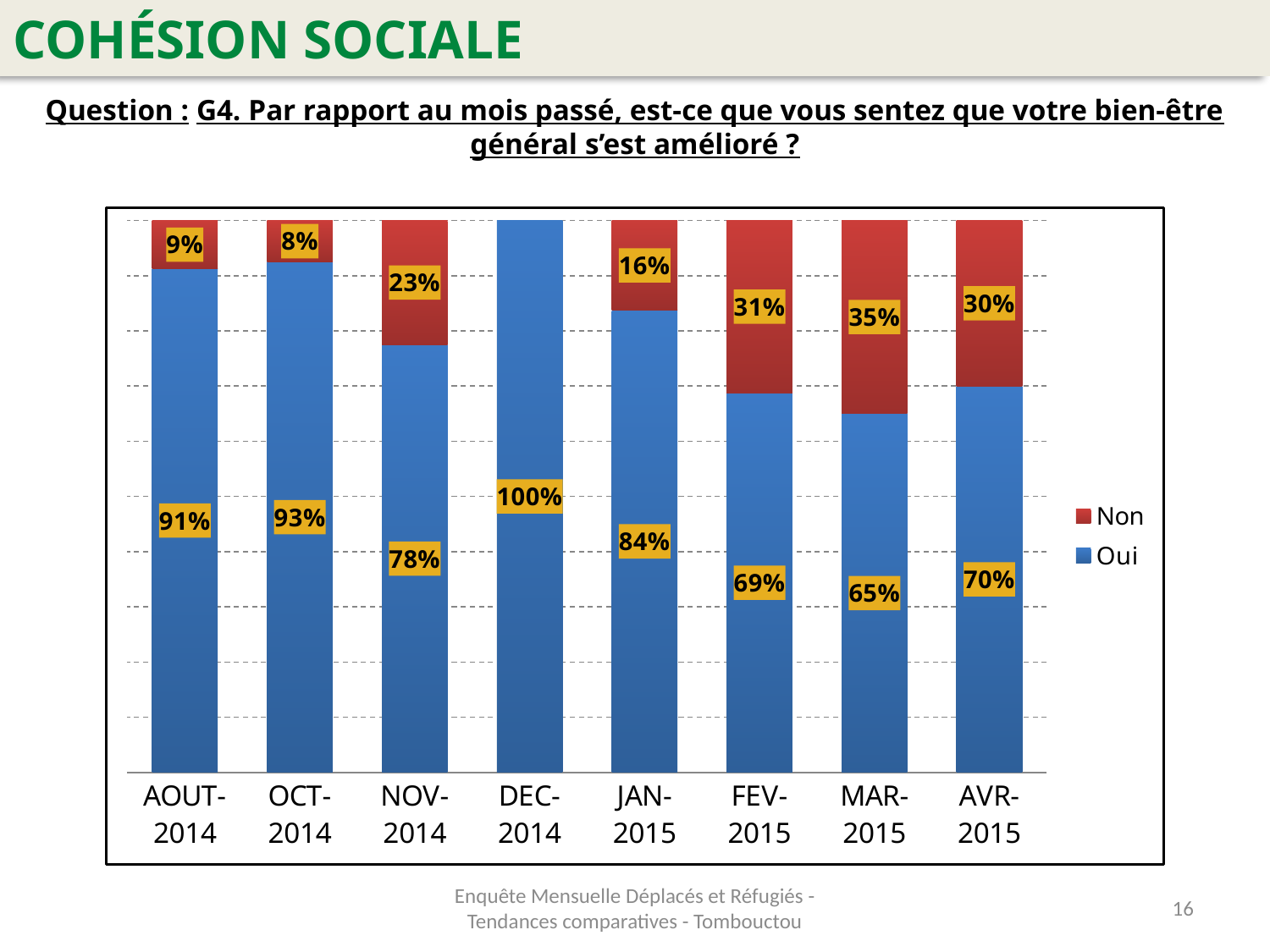
What is the total of the stacked bar for FEV-2015? 100% What is the difference between the Oui values for OCT-2014 and AVR-2015? 23% What is the value for Oui in DEC-2014? 100% What is the value for Oui in NOV-2014? 78% Which month has the lowest value for Oui? MAR-2015 Which is larger, the Non value for NOV-2014 or the Non value for JAN-2015? NOV-2014 What kind of chart is shown on the slide? stacked bar chart Which month has the highest value for Non? MAR-2015 What is the value for Non in FEV-2015? 31% How many months are shown on the x axis? 8 Which series is shown in red in the legend? Non How many series does the legend list? 2